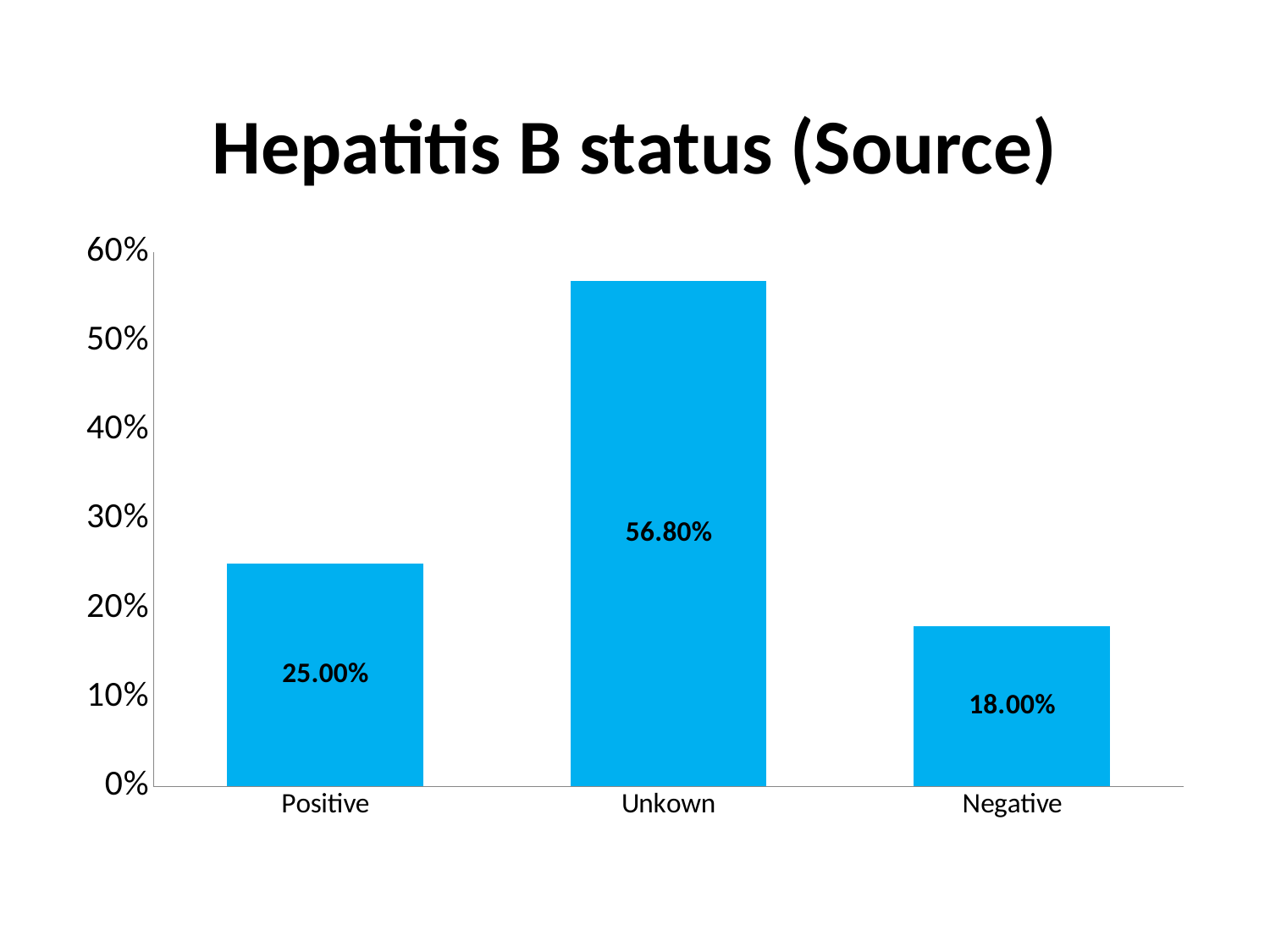
What is the difference between the values for Positive and Negative? 7.00% What is the value for Positive? 25.00% How many categories are shown on the x axis? 3 What is the title of the chart? Hepatitis B status (Source) What is the value for Negative? 18.00% Which is larger, the value for Positive or the value for Negative? Positive Which category has the lowest value? Negative What is the difference between the values for Unkown and Positive? 31.80% What is the value for Unkown? 56.80% Is the value for Unkown greater or less than 50%? greater What kind of chart is shown on the slide? bar chart Which category has the highest value? Unkown